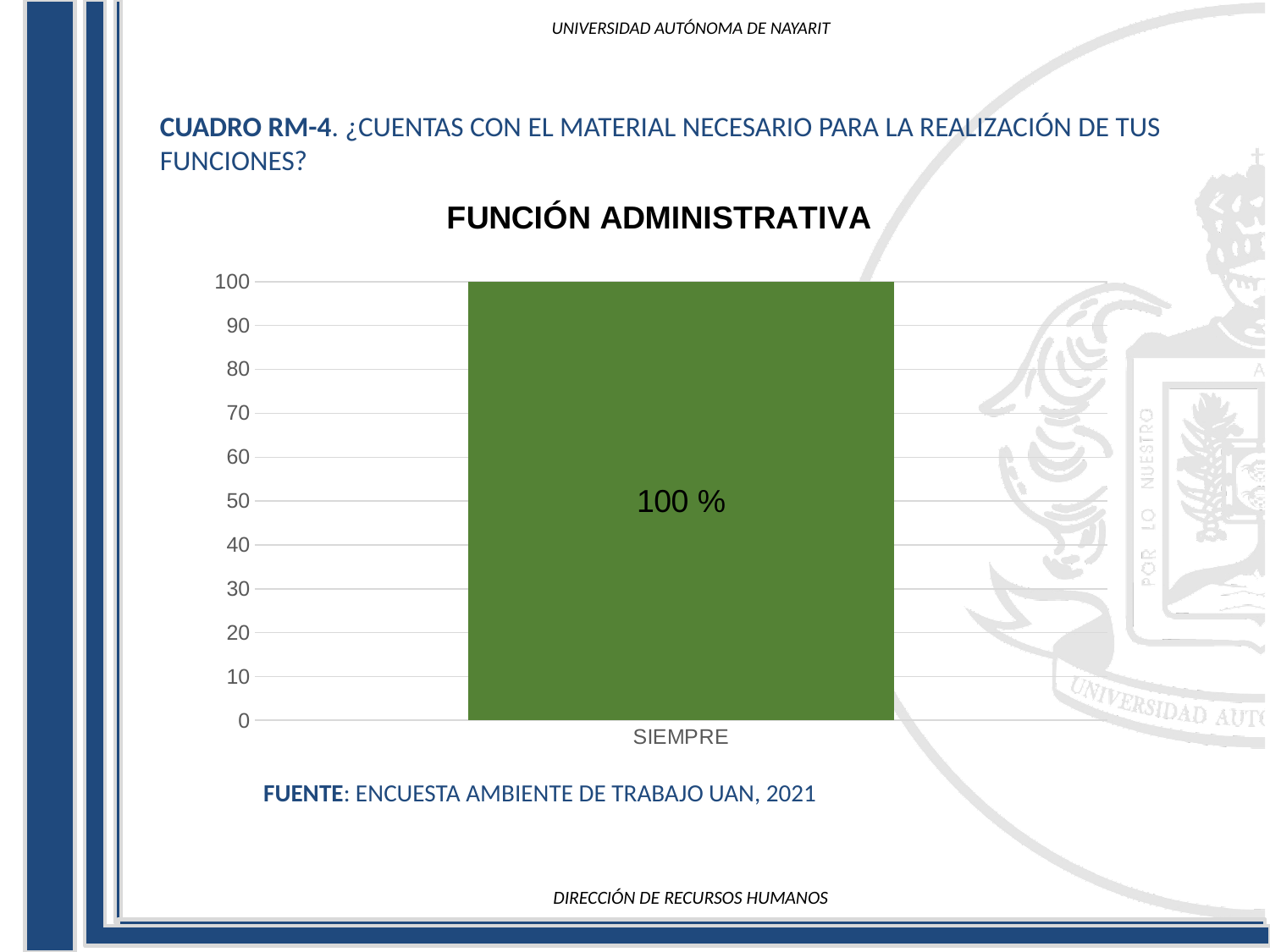
What is the label of the only category on the x axis? SIEMPRE What is the highest value shown on the y axis? 100 How many categories are shown on the x axis? 1 Which category has the highest value? SIEMPRE Is the value for SIEMPRE greater or less than 50? greater What is the title of the chart? FUNCIÓN ADMINISTRATIVA What is the value for SIEMPRE? 100 % What kind of chart is this? bar chart